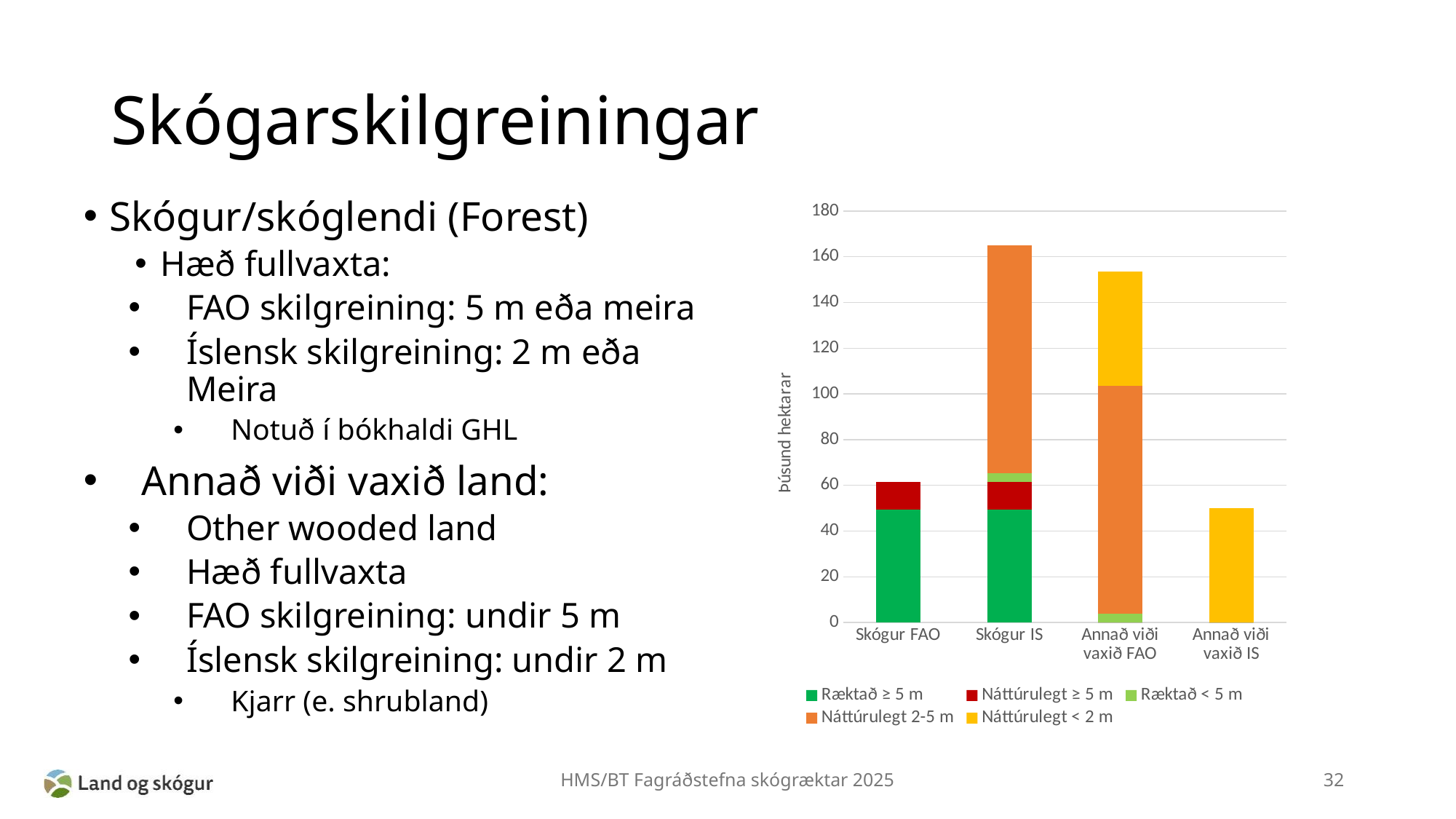
Which series is shown in yellow in the chart's legend? Náttúrulegt < 2 m Is the total value for Skógur IS greater or less than 160? greater Which category has the shortest stacked bar? Annað viði vaxið IS Is the total value for Skógur FAO greater or less than 80? less Is the total value for Annað viði vaxið FAO greater or less than 140? greater Which has a larger total, Skógur IS or Annað viði vaxið IS? Skógur IS How many categories are shown on the x axis of the chart? 4 Which category has the tallest stacked bar? Skógur IS What kind of chart is shown on the slide? stacked bar chart How many series does the chart's legend list? 5 What is the label on the vertical axis of the chart? þúsund hektarar Which has a larger total, Skógur FAO or Annað viði vaxið FAO? Annað viði vaxið FAO